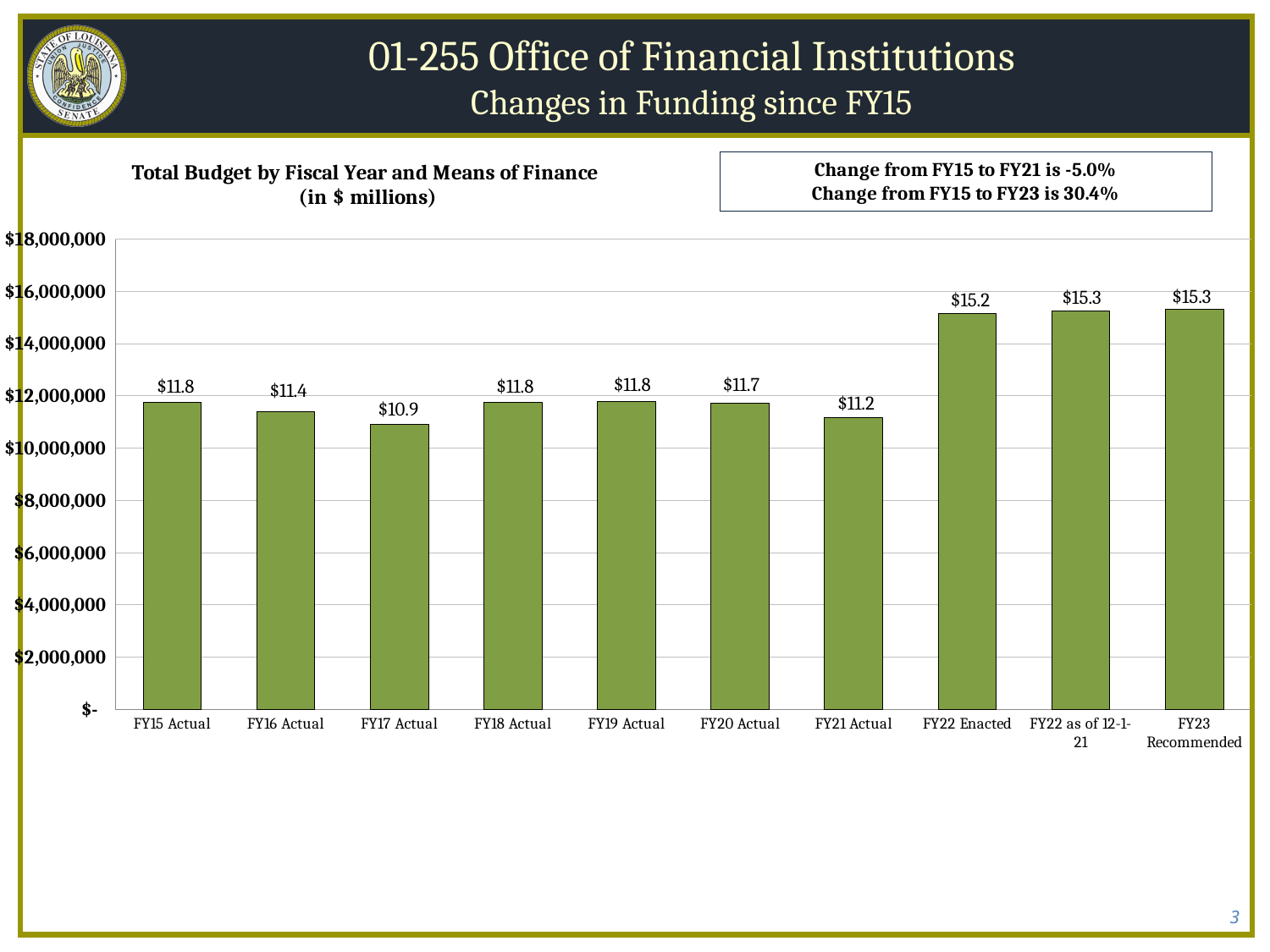
Do the values rise or fall from FY15 Actual to FY17 Actual? fall What is the value for FY21 Actual? $11.2 Which is larger, the value for FY22 Enacted or the value for FY21 Actual? FY22 Enacted What is the difference between the FY23 Recommended value and the FY15 Actual value? $3.6 What kind of chart is shown on the slide? bar chart What is the difference between the FY22 Enacted value and the FY21 Actual value? $4.0 Is the bar for FY22 Enacted greater or less than $14,000,000? greater How many fiscal year categories are shown on the x axis? 10 Is the bar for FY17 Actual greater or less than $12,000,000? less What is the value for FY22 Enacted? $15.2 What is the value for FY17 Actual? $10.9 Which fiscal year has the lowest total budget? FY17 Actual